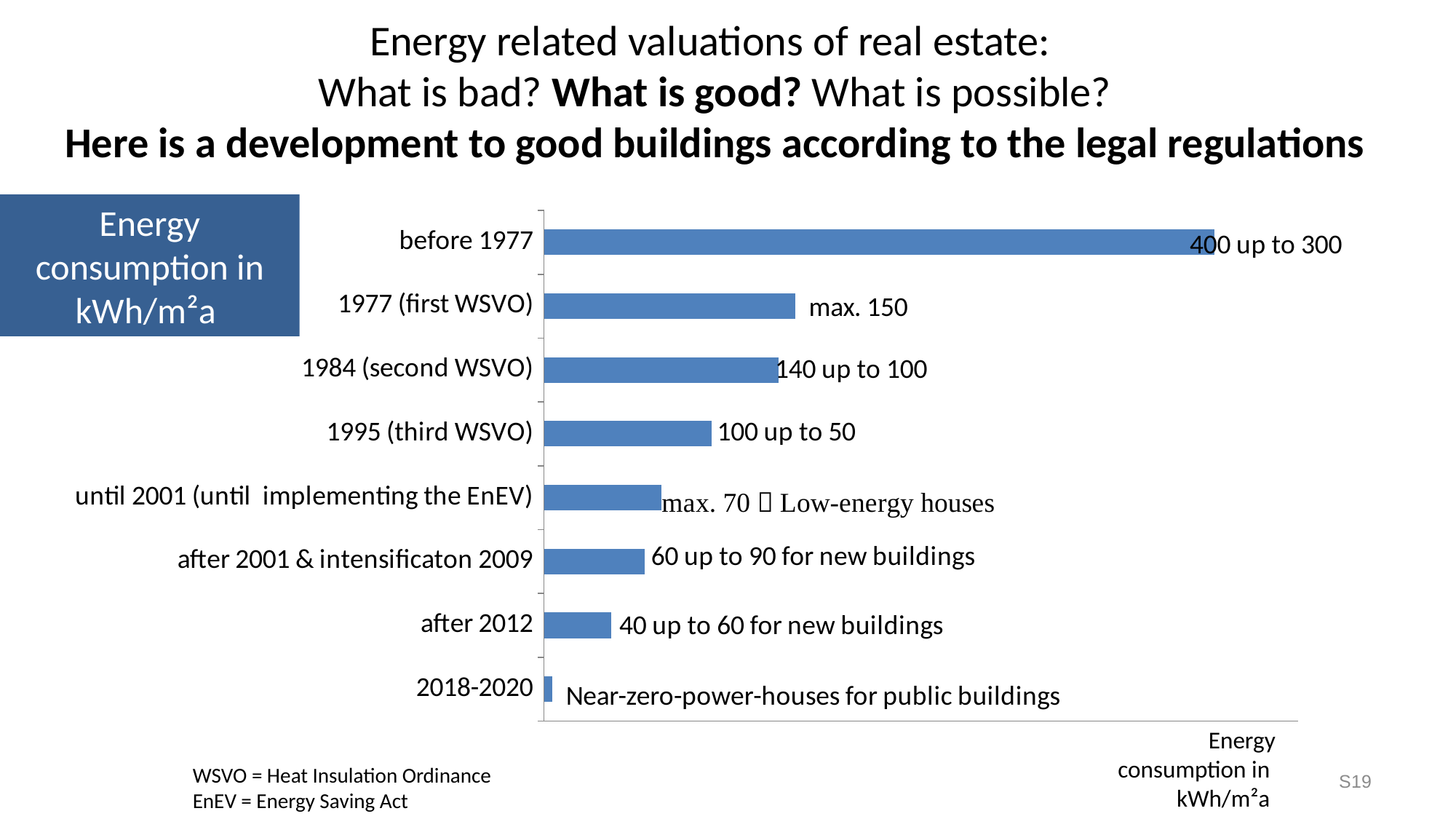
What is the data label on the bar for '1995 (third WSVO)'? 100 up to 50 What is the data label on the bar for '1977 (first WSVO)'? max. 150 What is the data label on the bar for 'after 2012'? 40 up to 60 for new buildings What is the data label on the bar for '1984 (second WSVO)'? 140 up to 100 Which bar is longer: '1984 (second WSVO)' or '1995 (third WSVO)'? 1984 (second WSVO) What kind of chart is shown on the slide? bar chart What unit is given for energy consumption in the chart's axis label? kWh/m²a Which category has the shortest bar? 2018-2020 Which category has the longest bar? before 1977 What is the data label on the bar for 'before 1977'? 400 up to 300 How many categories (bars) does the chart show? 8 Do the bar lengths rise or fall going from 'before 1977' down to '2018-2020'? fall